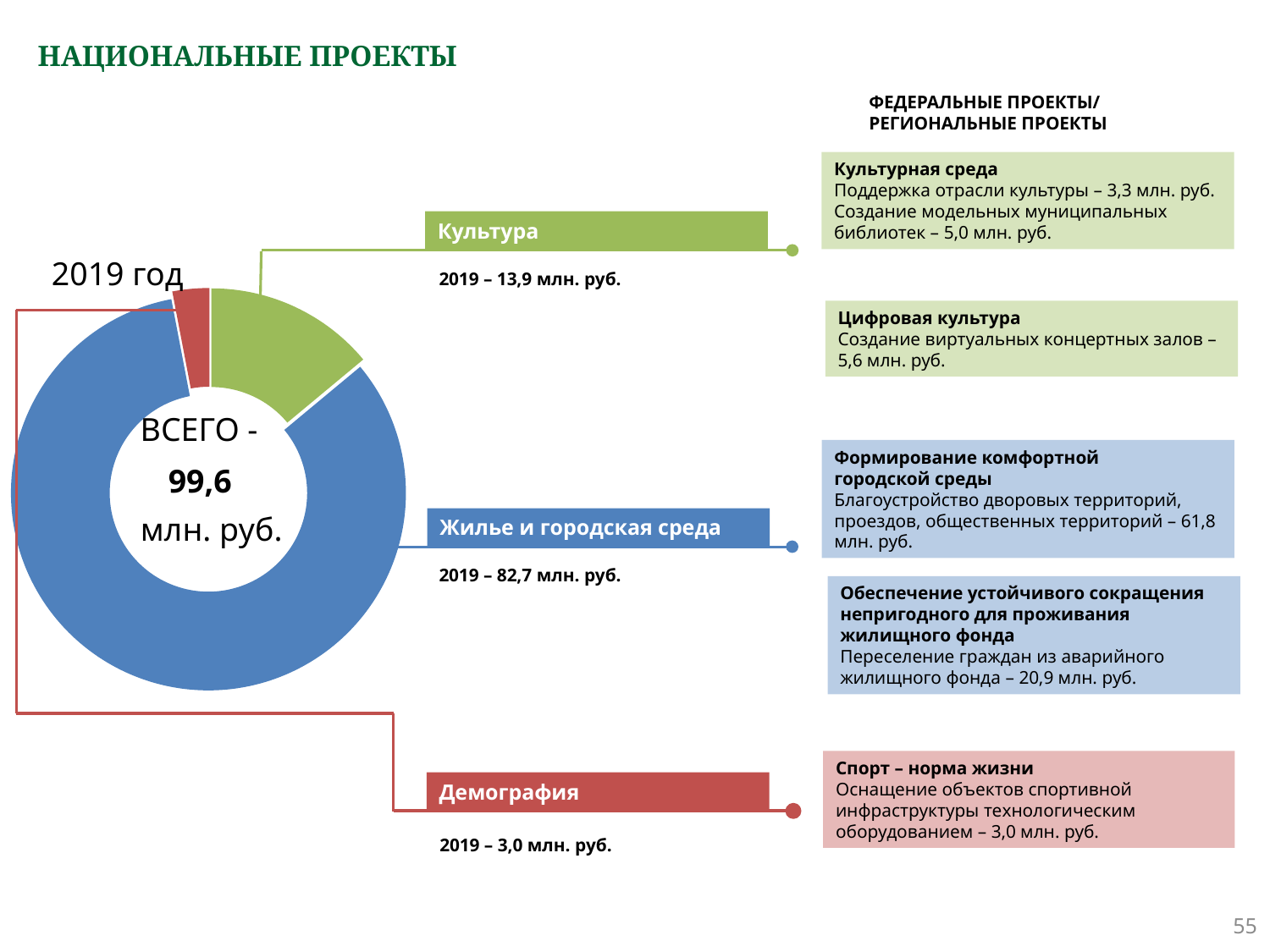
What is the difference between the values for Культура and Демография? 10,9 млн. руб. Which national project has the smallest segment in the pie chart? Демография What is the 2019 value for Культура in the pie chart? 13,9 млн. руб. What is the difference between the values for Жилье и городская среда and Культура? 68,8 млн. руб. What colour is the Жилье и городская среда segment in the pie chart? Blue What is the total shown in the centre of the pie chart? 99,6 млн. руб. What kind of chart is shown on the slide? Doughnut chart What is the 2019 value for Жилье и городская среда in the pie chart? 82,7 млн. руб. How many segments does the pie chart have? 3 What is the 2019 value for Демография in the pie chart? 3,0 млн. руб. Which is larger, the value for Культура or the value for Демография? Культура Which national project has the largest segment in the pie chart? Жилье и городская среда